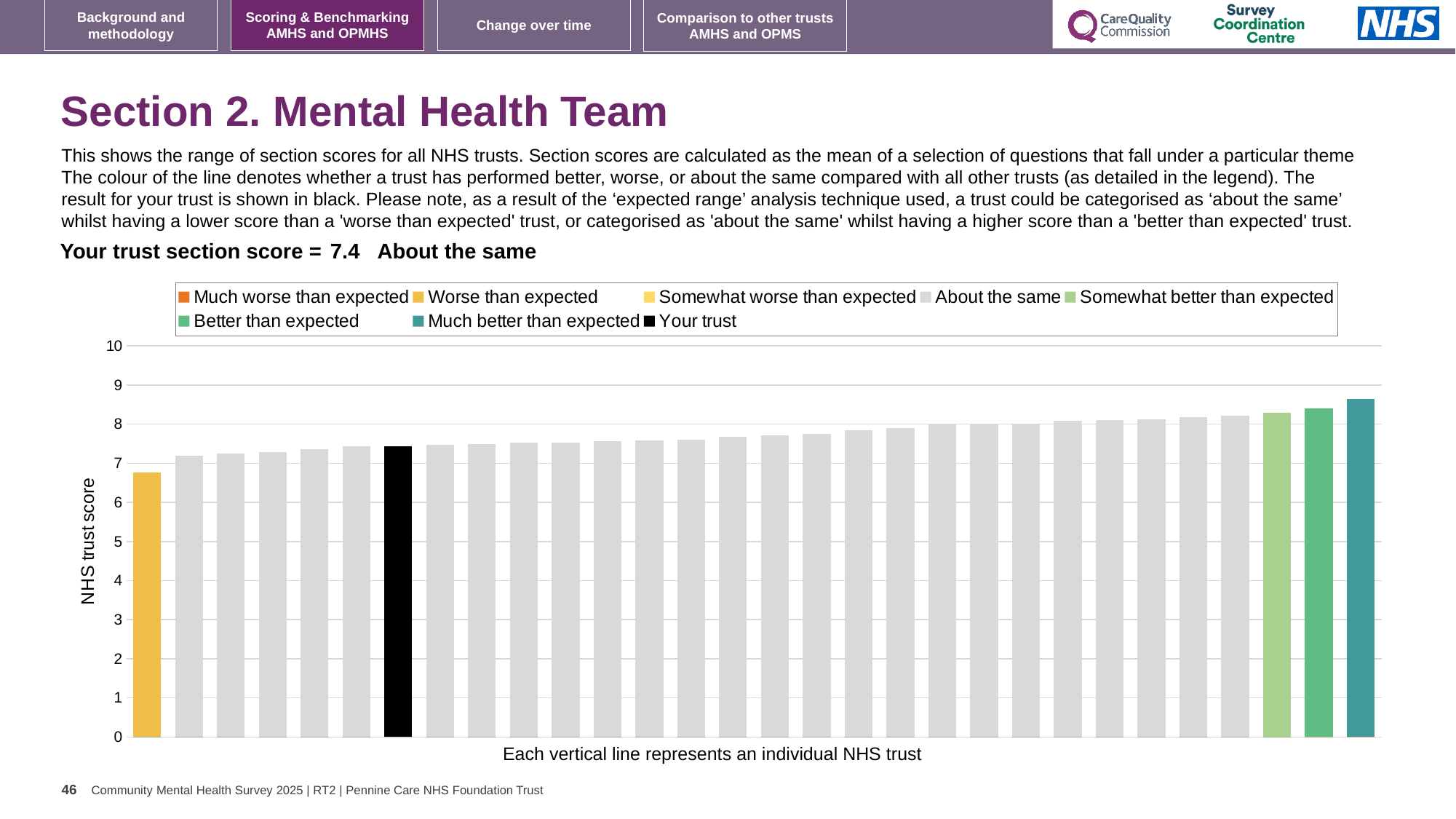
What is the label on the vertical axis of the chart? NHS trust score Is the value of the rightmost (teal) bar greater or less than 8? greater Which category is your trust's section score placed in? About the same Is the value of the leftmost (yellow) bar greater or less than 7? less Which legend category does the lowest bar belong to? Worse than expected Do the bar values rise or fall from left to right along the x axis? rise How many entries does the chart legend list? 8 Which legend category does the highest bar belong to? Much better than expected What colour is the bar representing your trust? black What kind of chart is shown on the slide? bar chart What is the section score for your trust shown on the slide? 7.4 Is the value of the black 'Your trust' bar greater or less than 7? greater